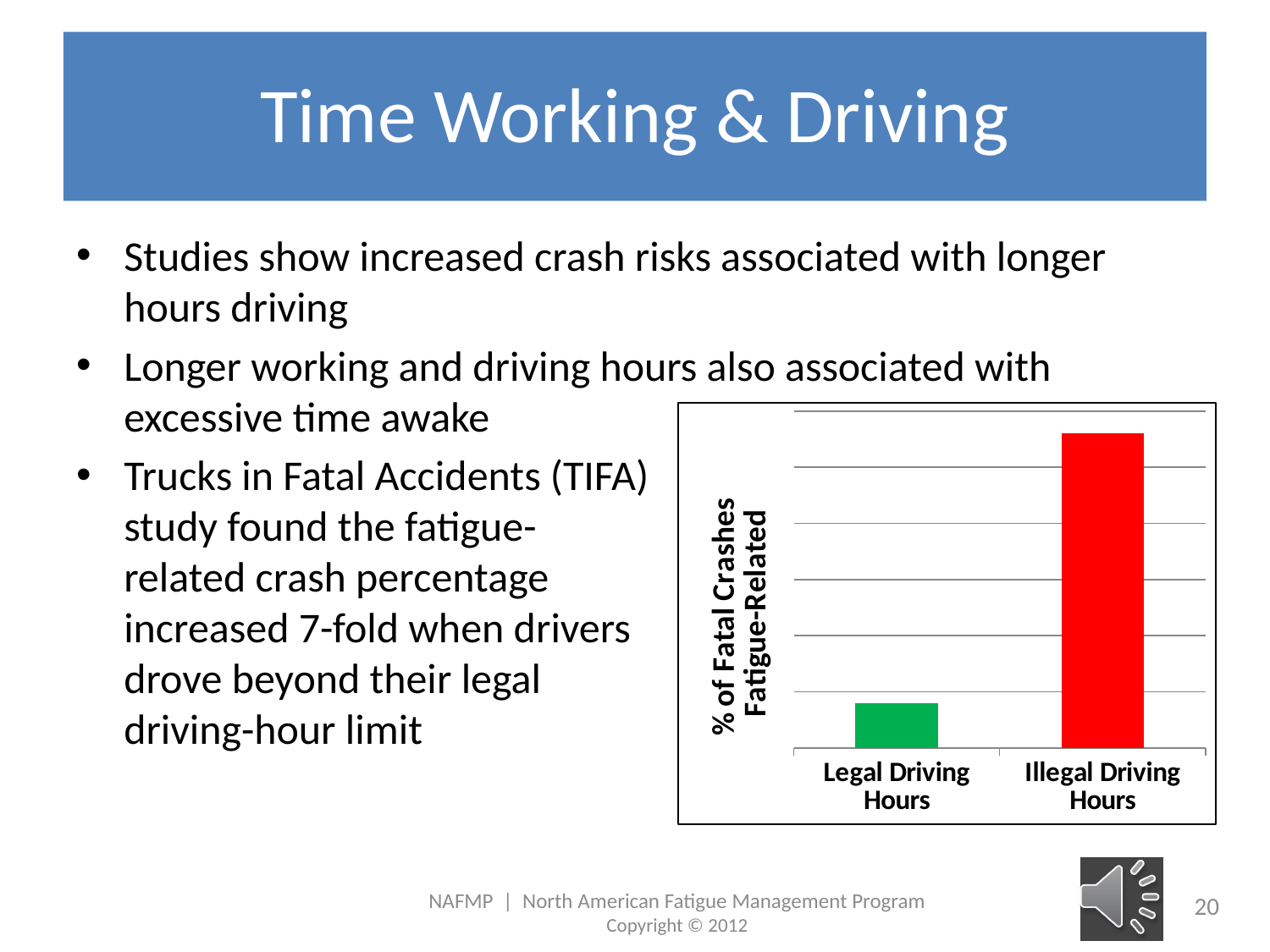
Which category has the lowest bar in the chart? Legal Driving Hours What kind of chart is shown on the slide? bar chart What is the title of the vertical axis of the chart? % of Fatal Crashes Fatigue-Related Which category has the highest bar in the chart? Illegal Driving Hours Which is larger in the chart, the bar for Legal Driving Hours or the bar for Illegal Driving Hours? Illegal Driving Hours How many categories are shown on the x axis of the chart? 2 What colour is the bar for Illegal Driving Hours in the chart? red